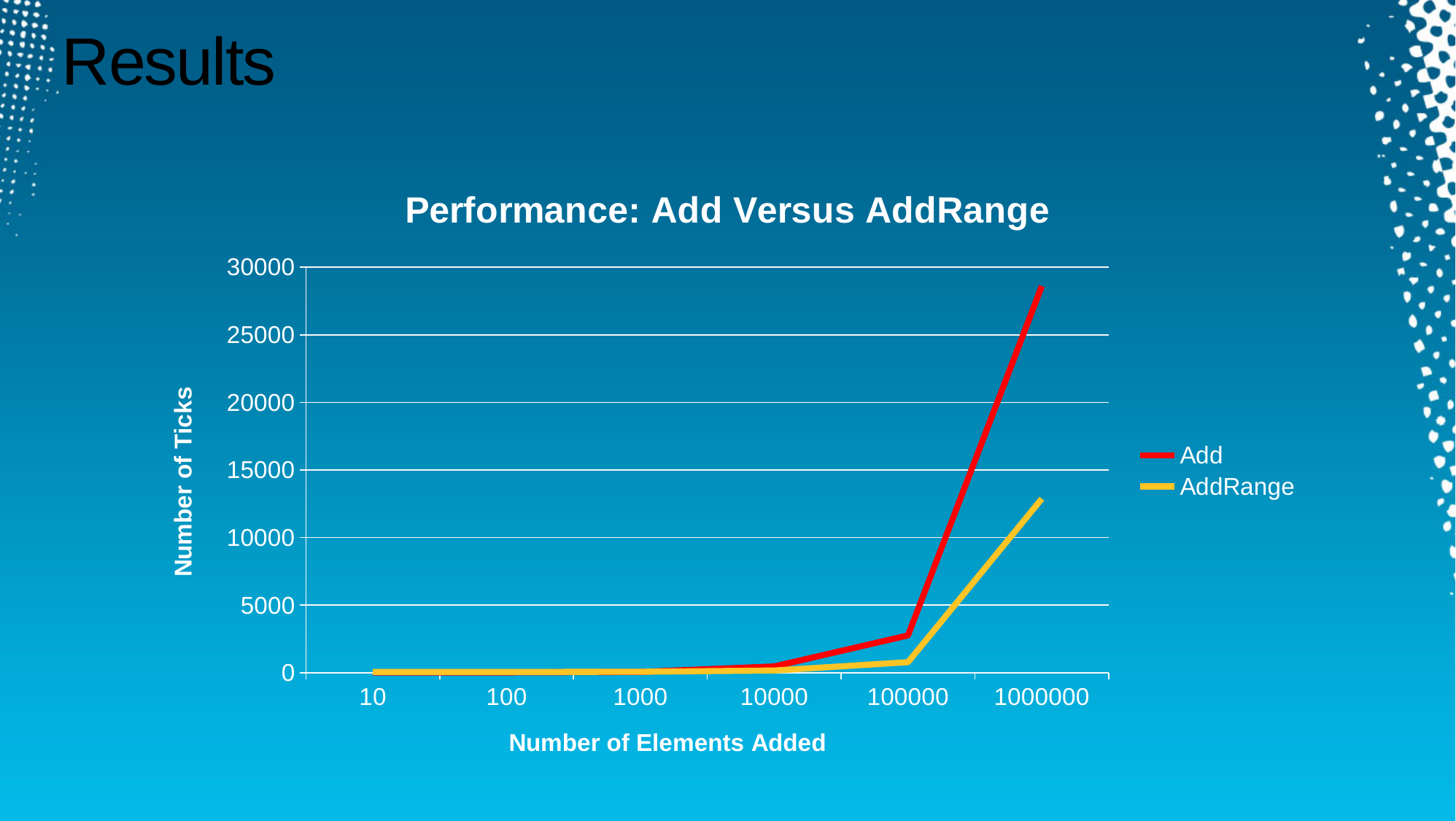
How many series does the legend list? 2 How many points are plotted along the x axis for each series? 6 At which number of elements added does the Add series reach its highest value? 1000000 What kind of chart is shown on the slide? line chart Which series has the higher value at 1000000 elements added? Add Is the value for Add at 1000000 elements greater or less than 25000? greater Is the value for AddRange at 1000000 elements greater or less than 15000? less Do the values for AddRange rise or fall as the number of elements added increases? rise What is the label of the y axis? Number of Ticks Is the value for Add at 100000 elements greater or less than 5000? less What is the title of the chart? Performance: Add Versus AddRange